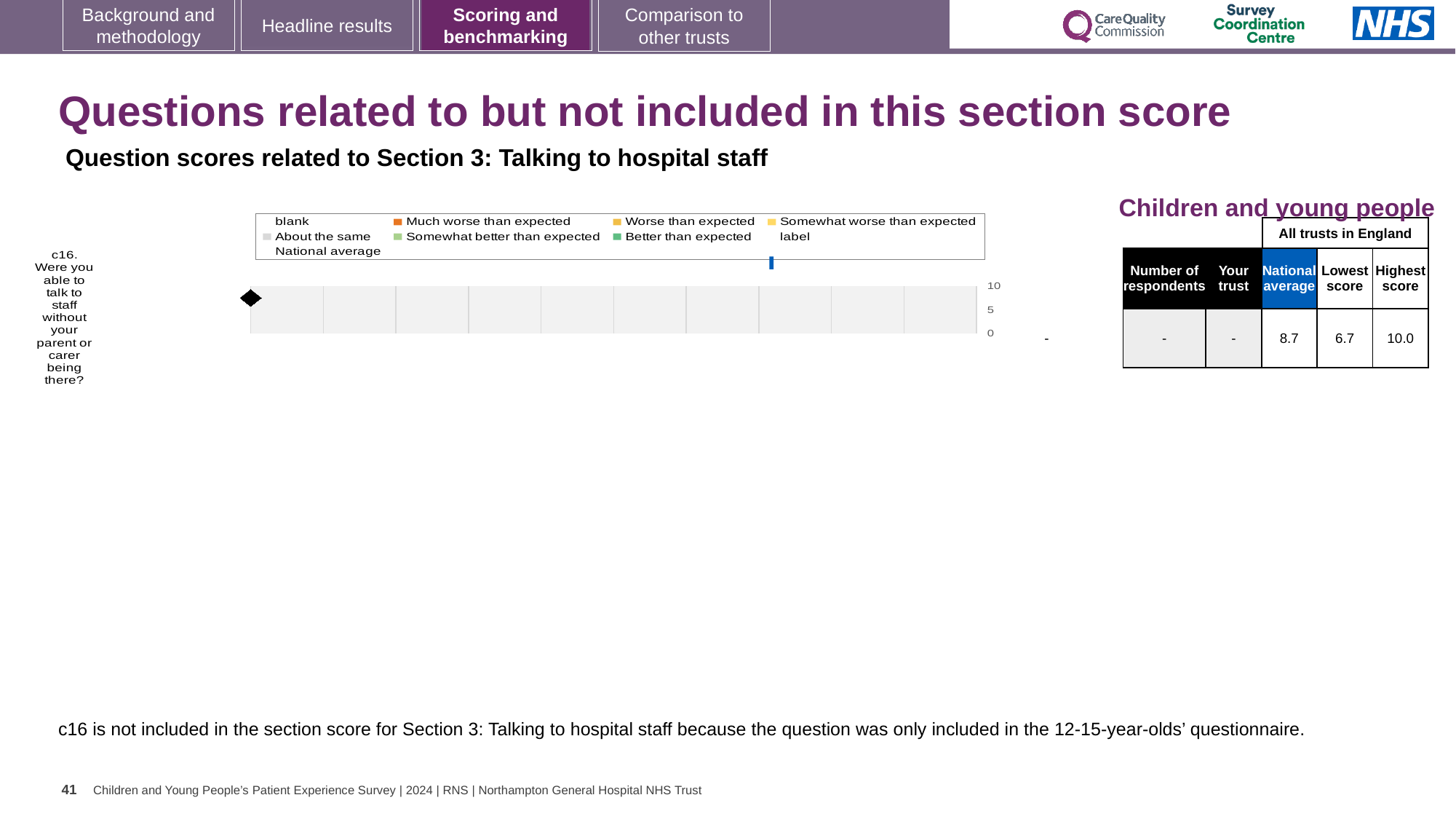
How many entries does the chart's legend list? 9 In the table beside the chart, what is the Highest score for c16? 10.0 What kind of chart is shown on the slide? bar chart In the table beside the chart, which is larger for c16: the National average or the Lowest score? National average In the table beside the chart, what value is shown for Your trust for c16? - In the table beside the chart, what is the National average score for c16? 8.7 How many questions (categories) are listed on the chart's vertical axis? 1 What is the highest value shown on the chart's numeric axis? 10 In the table beside the chart, what is the Lowest score for c16? 6.7 Which question number is plotted on the chart? c16 In the table beside the chart, what is the difference between the Highest score and the Lowest score for c16? 3.3